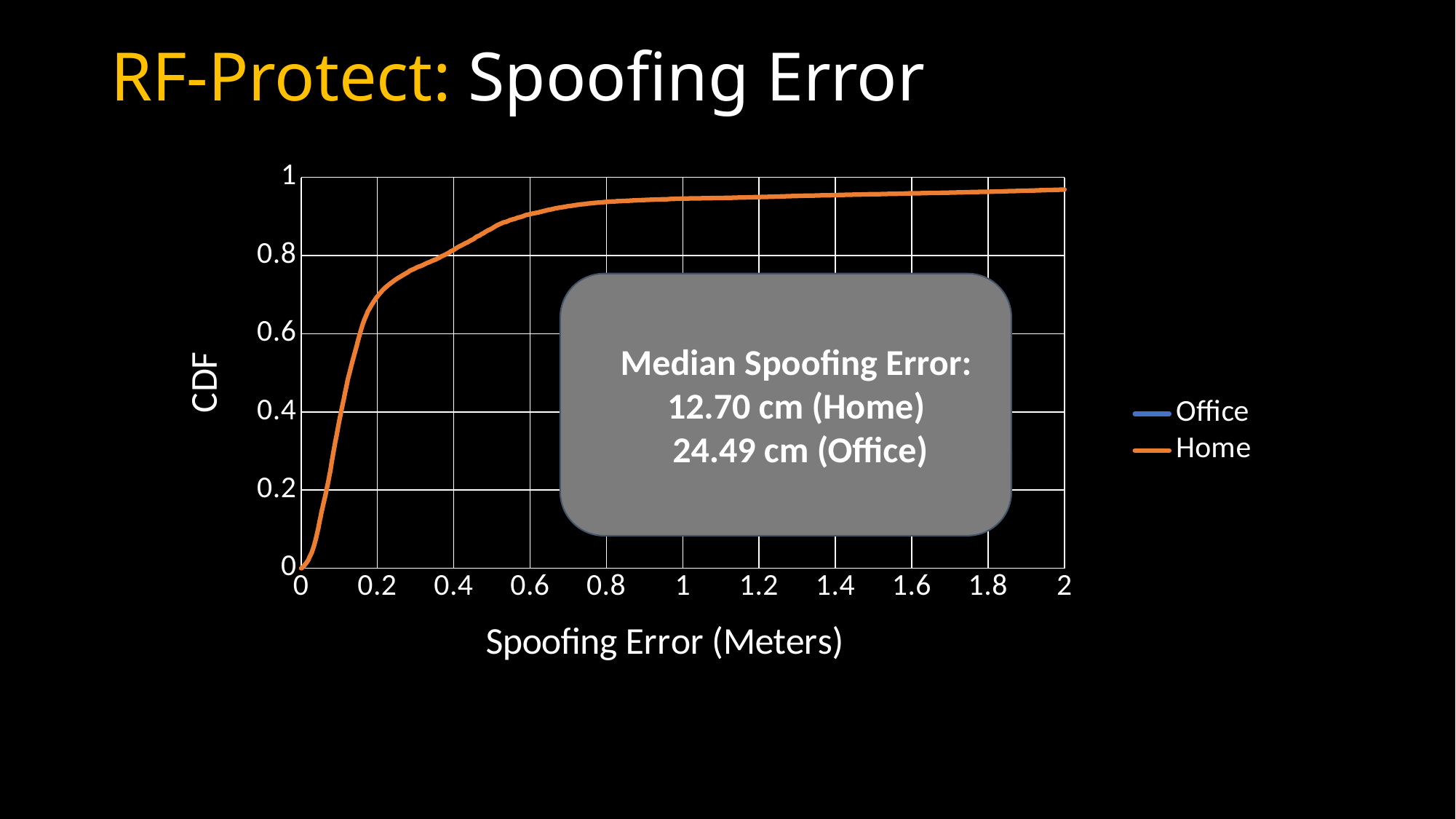
Is the CDF value of the Home curve at a spoofing error of 0.2 meters greater or less than 0.6? greater What kind of chart is shown on the slide? line chart What is the median spoofing error for Office, as stated on the slide? 24.49 cm What is the median spoofing error for Home, as stated on the slide? 12.70 cm Which has the larger median spoofing error, Home or Office? Office What is the difference between the Office and Home median spoofing errors? 11.79 cm Is the CDF value of the Home curve at a spoofing error of 1 meter greater or less than 0.8? greater Does the Home CDF curve rise or fall as spoofing error increases along the x axis? rise What colour is the Home series in the legend? orange Is the CDF value of the Home curve at a spoofing error of 0.6 meters greater or less than 0.8? greater What is the label of the x axis? Spoofing Error (Meters) How many series does the legend list? 2